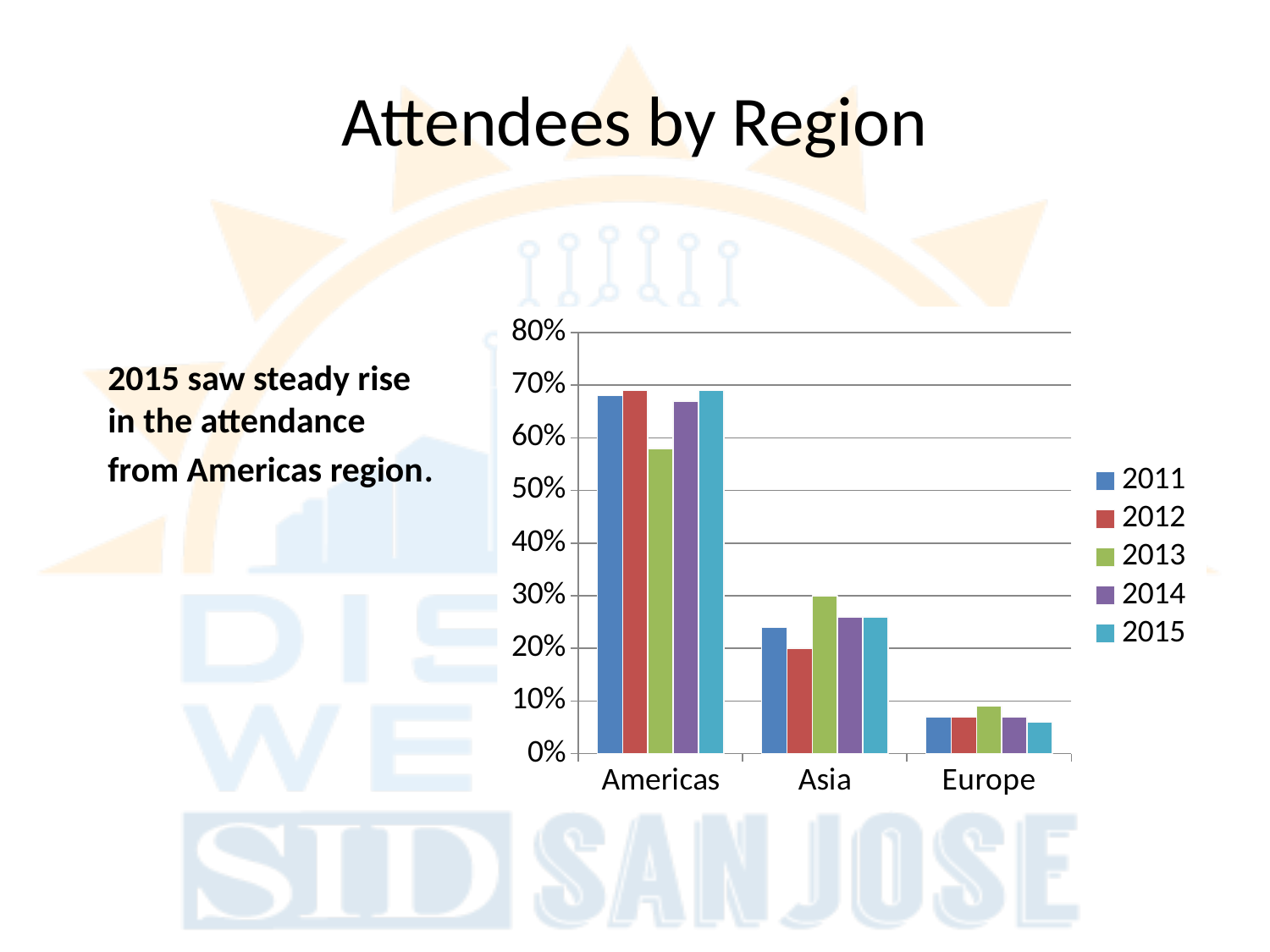
What is the title of the chart on the slide? Attendees by Region What kind of chart is shown on the slide? bar chart Is the value for Asia in 2013 greater or less than 20%? greater Within the Americas group, which year has the lowest bar? 2013 Which region has the highest attendance share in the chart? Americas Is the value for Europe in 2013 greater or less than 10%? less How many regions are shown on the x axis of the chart? 3 Within the Asia group, which year has the highest bar? 2013 Is the value for Americas in 2013 greater or less than 60%? less Which is larger: the Asia value for 2012 or the Asia value for 2013? 2013 Which region has the lowest attendance share in the chart? Europe How many series does the chart's legend list? 5